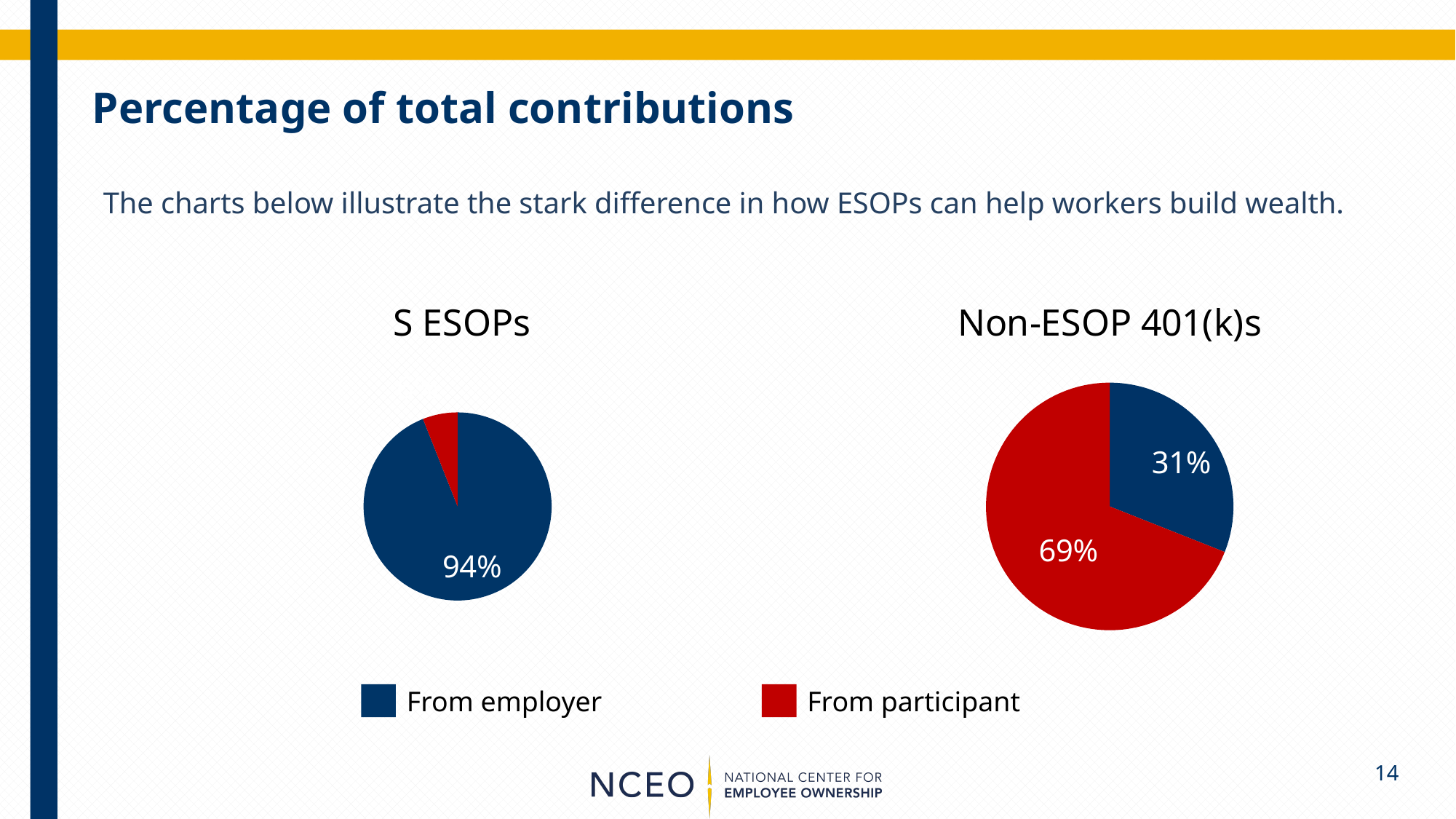
How many entries does the legend list? 2 In the S ESOPs chart, is the employer share greater or less than 50%? greater In the Non-ESOP 401(k)s chart, what percentage of total contributions comes from the employer? 31% In the Non-ESOP 401(k)s chart, which source accounts for the largest share of contributions? From participant Which colour represents 'From participant' in the legend? Red In the S ESOPs chart, which source accounts for the smallest share of contributions? From participant Which chart shows a larger employer share of contributions, S ESOPs or Non-ESOP 401(k)s? S ESOPs What kind of chart is used for S ESOPs and Non-ESOP 401(k)s? Pie chart In the S ESOPs chart, what percentage of total contributions comes from the employer? 94% In the Non-ESOP 401(k)s chart, what is the difference between the participant share and the employer share? 38% How many slices does each pie chart have? 2 In the Non-ESOP 401(k)s chart, what percentage of total contributions comes from the participant? 69%